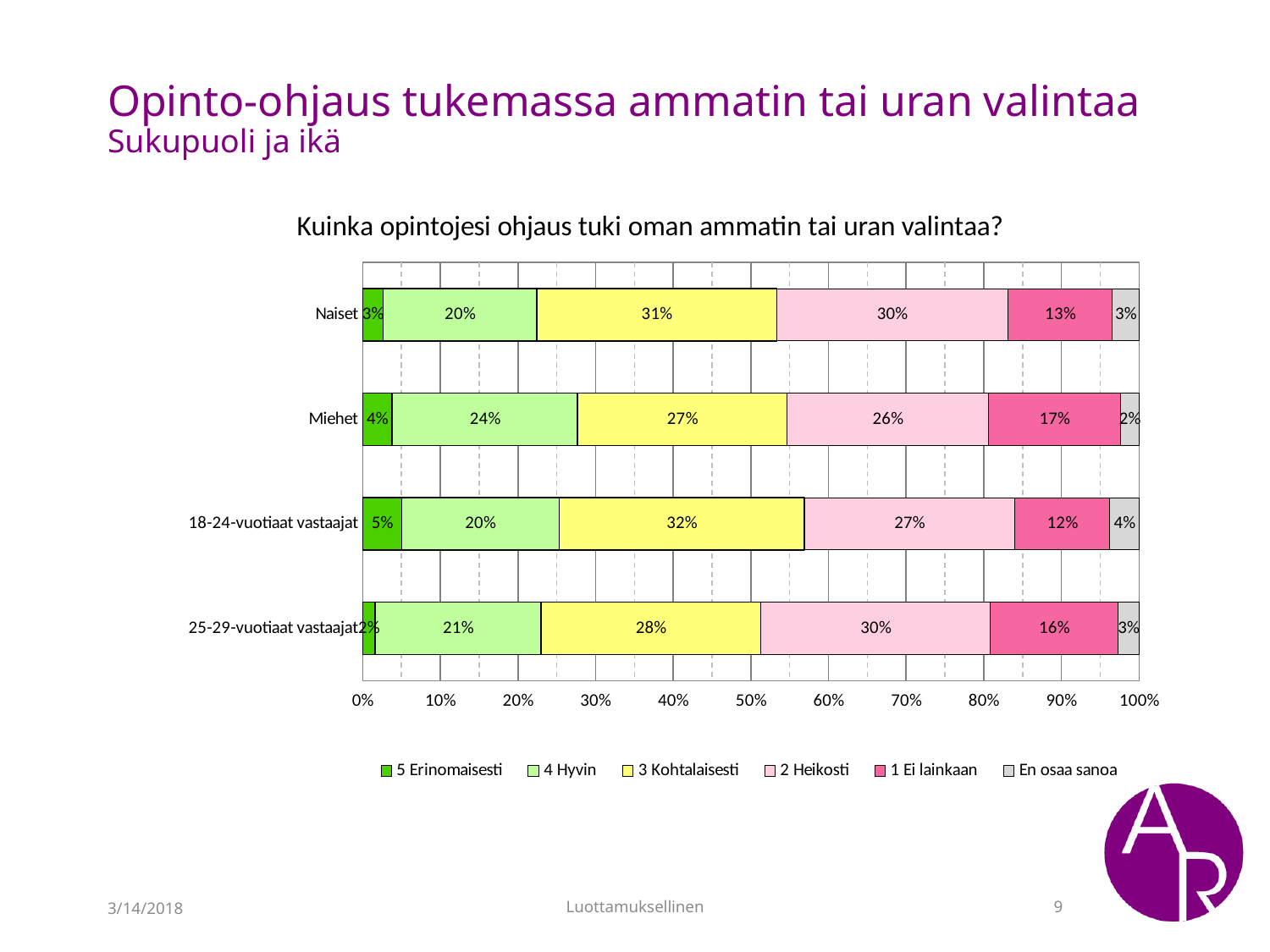
How many categories are plotted on the chart? 4 What is the value of '1 Ei lainkaan' for Miehet? 17% What is the title of the chart? Kuinka opintojesi ohjaus tuki oman ammatin tai uran valintaa? How many series does the legend list? 6 What is the value of '5 Erinomaisesti' for 18-24-vuotiaat vastaajat? 5% Which category has the lowest value for '5 Erinomaisesti'? 25-29-vuotiaat vastaajat What is the difference between the '1 Ei lainkaan' values for Miehet and 18-24-vuotiaat vastaajat? 5% Which is larger: the '3 Kohtalaisesti' value for 18-24-vuotiaat vastaajat or for 25-29-vuotiaat vastaajat? 18-24-vuotiaat vastaajat What is the value of '3 Kohtalaisesti' for Naiset? 31% What kind of chart is shown on the slide? Stacked bar chart What is the value of '2 Heikosti' for 25-29-vuotiaat vastaajat? 30% Which category has the highest value for '4 Hyvin'? Miehet